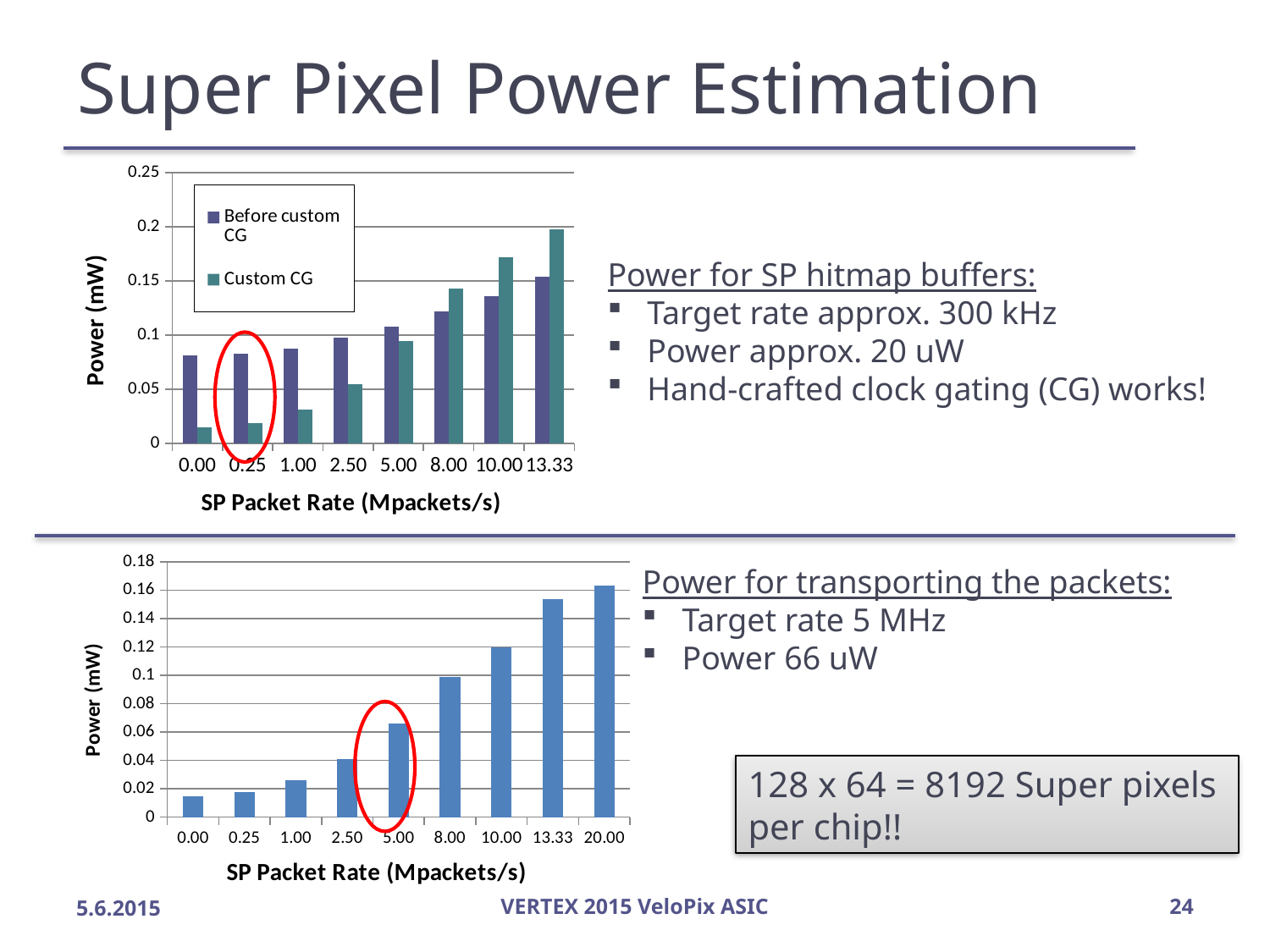
In the top chart, at 0.25 Mpackets/s, which series has the larger power: Before custom CG or Custom CG? Before custom CG What kind of chart is the top chart on the slide? bar chart In the top chart, at which SP packet rate is the Custom CG power highest? 13.33 How many series does the legend of the top chart list? 2 In the bottom chart, at which SP packet rate is the power highest? 20.00 What is the y-axis label of the bottom chart? Power (mW) In the top chart, at which SP packet rate is the Custom CG power lowest? 0.00 In the bottom chart, is the value at 1.00 Mpackets/s greater or less than 0.04 mW? less How many bars are plotted in the bottom chart? 9 In the top chart, is the Custom CG value at 0.25 Mpackets/s greater or less than 0.05 mW? less In the top chart, is the Custom CG value at 13.33 Mpackets/s greater or less than 0.15 mW? greater How many SP packet rate categories are shown on the x axis of the top chart? 8